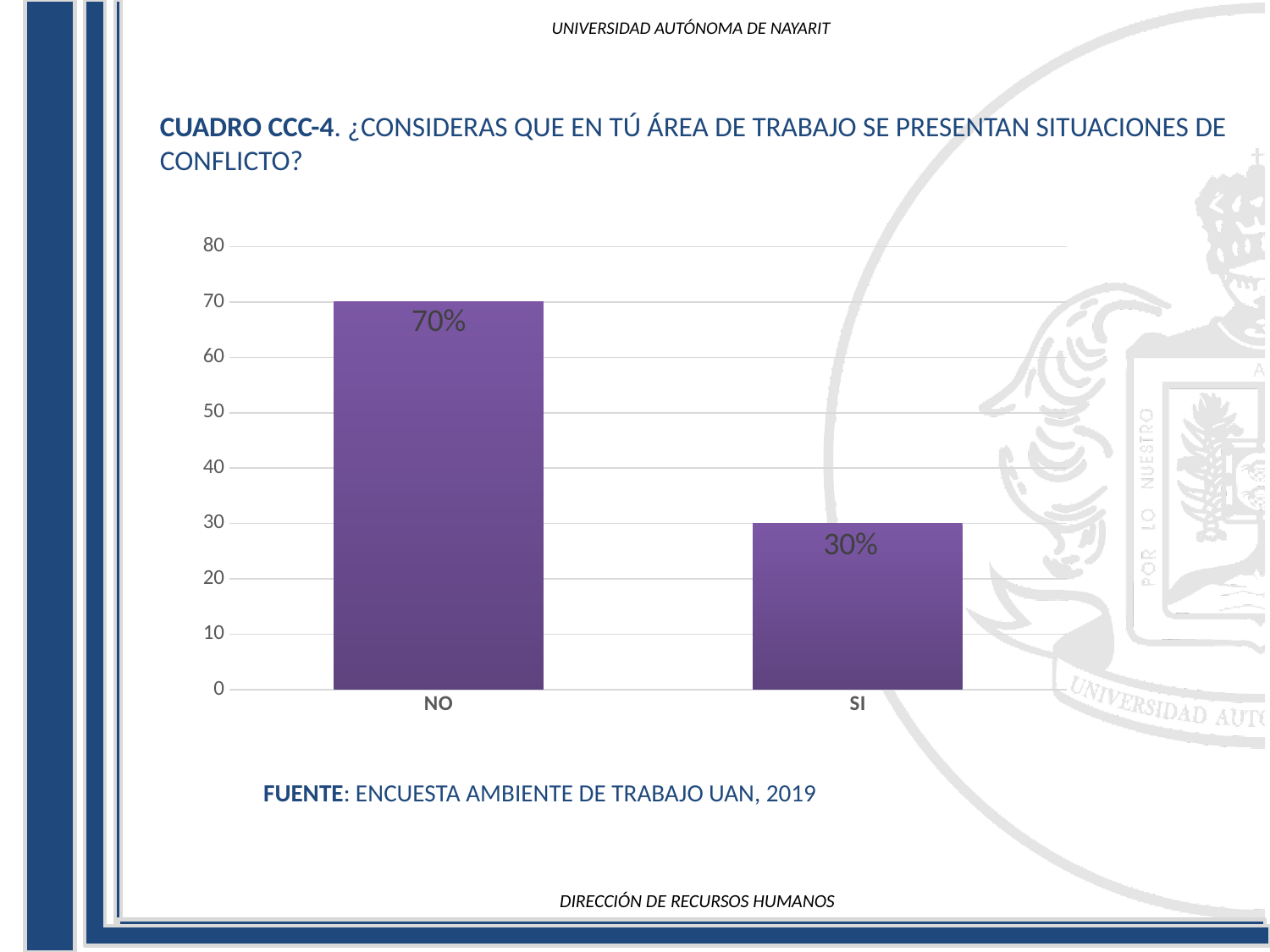
What kind of chart is shown on the slide? bar chart Is the value for NO greater or less than 60? greater What is the value for SI? 30% What is the highest value shown on the y axis? 80 Which is larger, the value for NO or the value for SI? NO Which category has the lowest value? SI How many categories are shown on the x axis? 2 What source is cited below the chart? ENCUESTA AMBIENTE DE TRABAJO UAN, 2019 What is the value for NO? 70% Which category has the highest value? NO Is the value for SI greater or less than 40? less What is the difference between the values for NO and SI? 40%